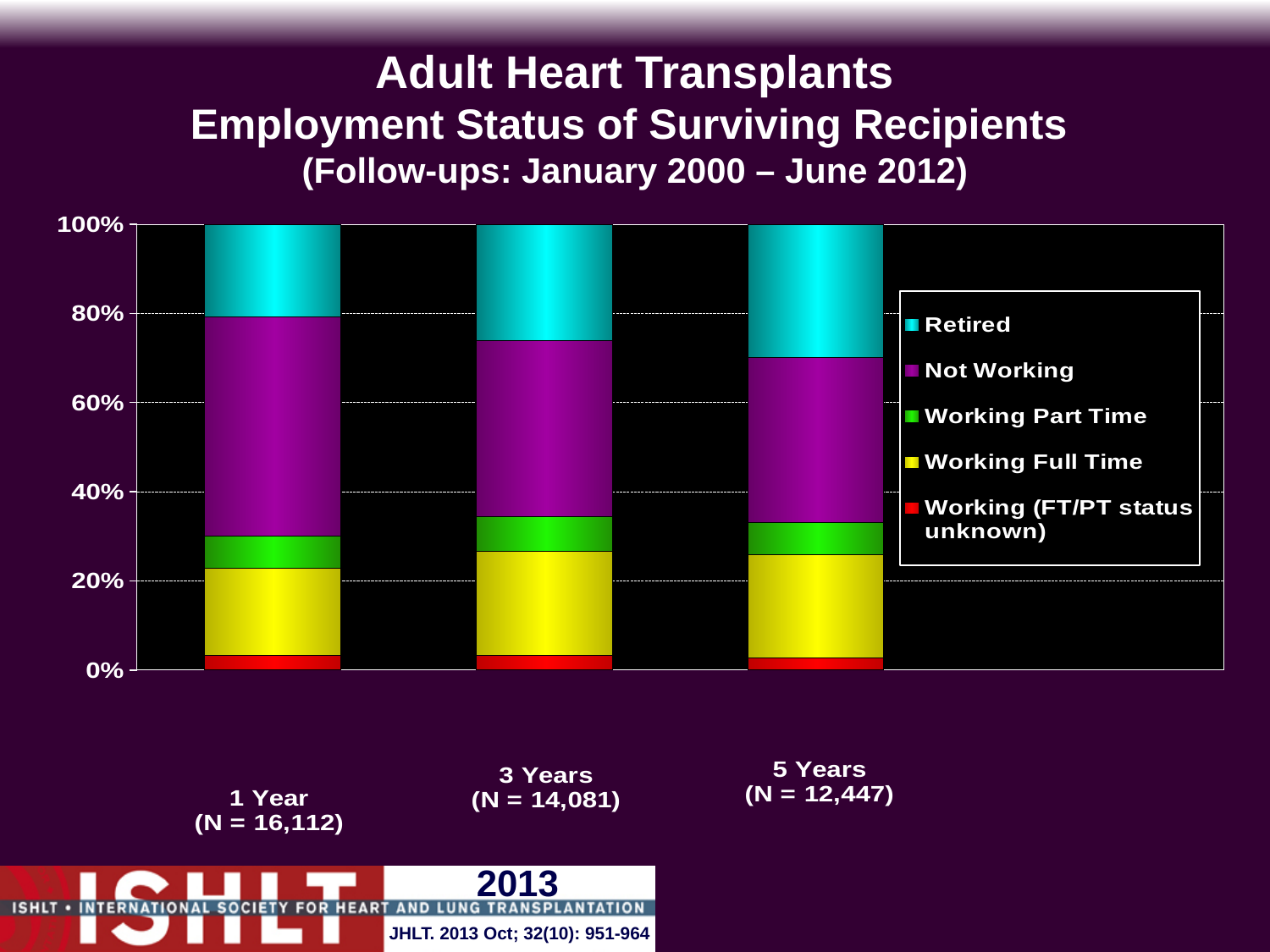
How many series does the legend list? 5 Is the Working Full Time share at 1 Year greater or less than 40%? less Does the Not Working share rise or fall from 1 Year to 5 Years? Fall Which colour represents Retired in the legend? Cyan Is the Not Working share at 1 Year greater or less than 40%? greater At 1 Year, which is larger: the Not Working share or the Retired share? Not Working How many follow-up time points (categories) are plotted on the x axis? 3 Does the Retired share rise or fall from 1 Year to 5 Years? Rise What kind of chart is shown on the slide? Stacked bar chart Is the Retired share at 5 Years greater or less than 20%? greater What is the N shown for the 3 Years follow-up? N = 14,081 Is the Retired share larger at 1 Year or at 5 Years? 5 Years